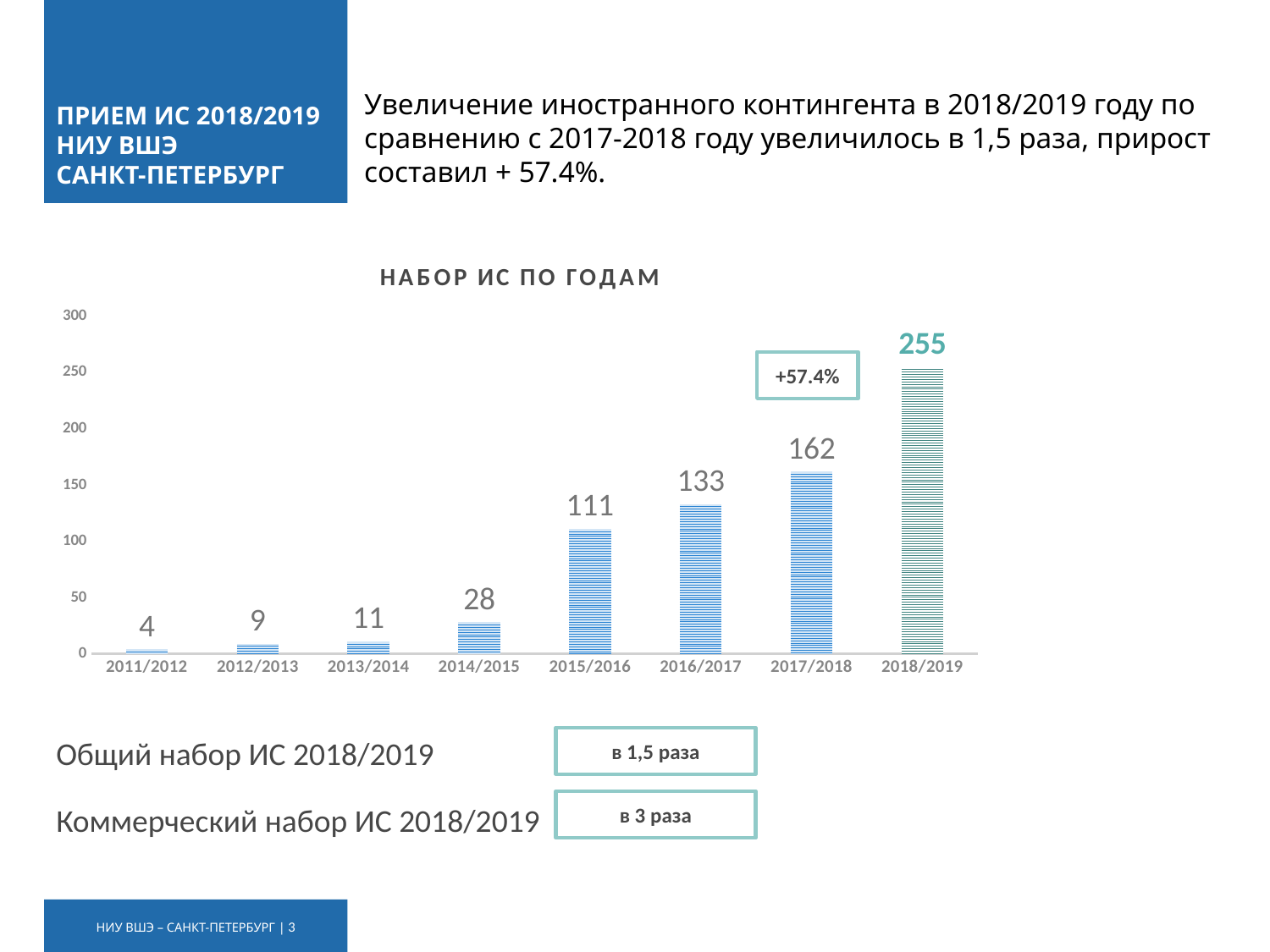
What is the value for 2015/2016? 111 What is the title of the chart? НАБОР ИС ПО ГОДАМ What is the value for 2011/2012? 4 Which year has the highest value? 2018/2019 How many years are shown on the x axis? 8 Which year has the lowest value? 2011/2012 What kind of chart is this? bar chart What is the difference between the values for 2018/2019 and 2017/2018? 93 Which is larger, the value for 2016/2017 or the value for 2014/2015? 2016/2017 Do the values rise or fall from 2011/2012 to 2018/2019? rise What is the value for 2018/2019? 255 Is the value for 2017/2018 greater or less than 150? greater